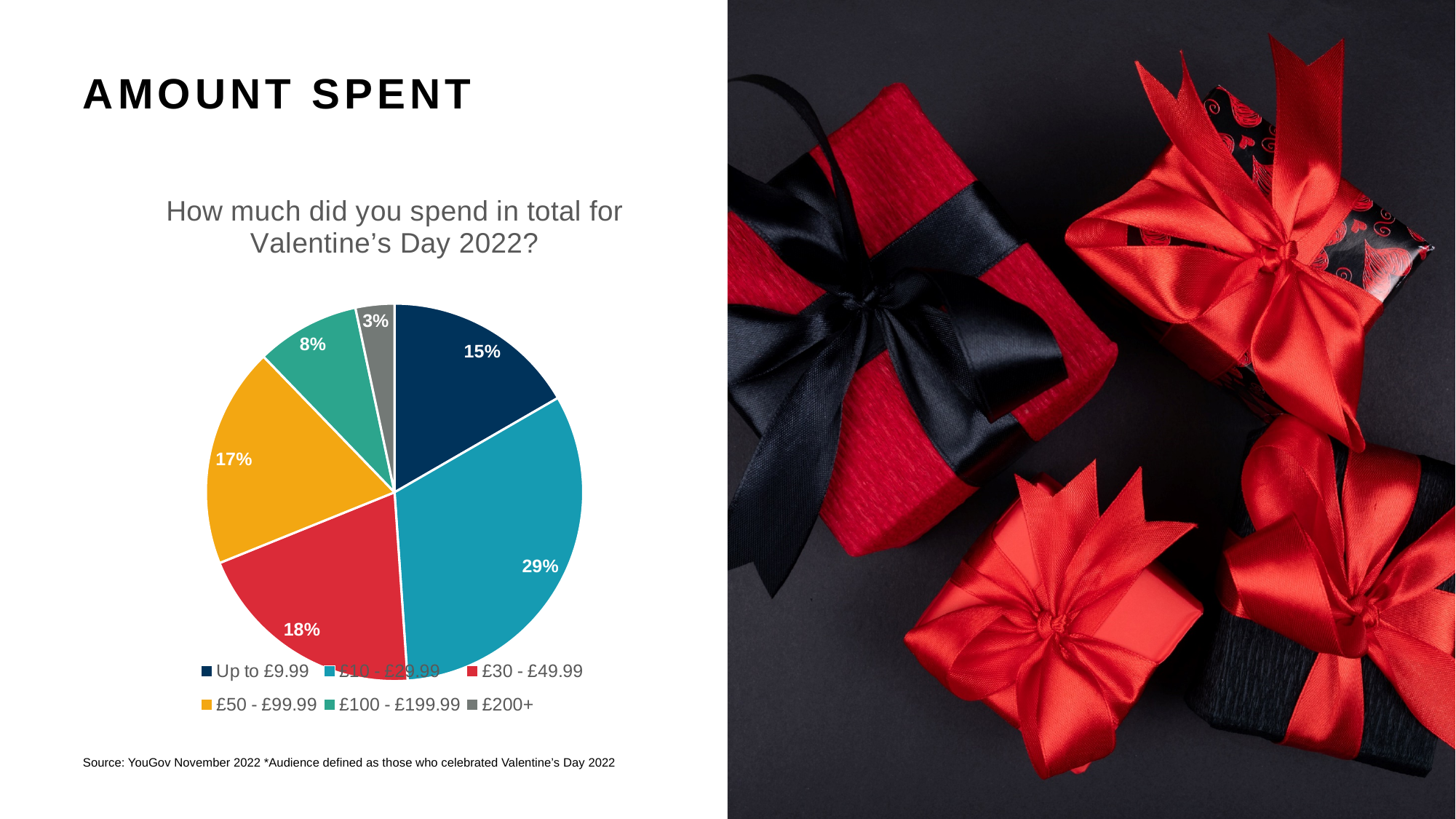
What is the difference in percentage points between the £30 - £49.99 and £50 - £99.99 slices? 1 What percentage of respondents spent £200+? 3% What kind of chart is shown on the slide? Pie chart How many spending bands (slices) does the pie chart show? 6 What is the combined share of the £100 - £199.99 and £200+ slices? 11% What percentage of respondents spent £10 - £29.99 for Valentine's Day 2022? 29% Which spending band has the largest share of the pie? £10 - £29.99 What percentage of respondents spent £100 - £199.99? 8% What question is the pie chart titled with? How much did you spend in total for Valentine's Day 2022? What percentage of respondents spent up to £9.99? 15% Which is larger: the share for £10 - £29.99 or the share for Up to £9.99? £10 - £29.99 Which spending band has the smallest share of the pie? £200+